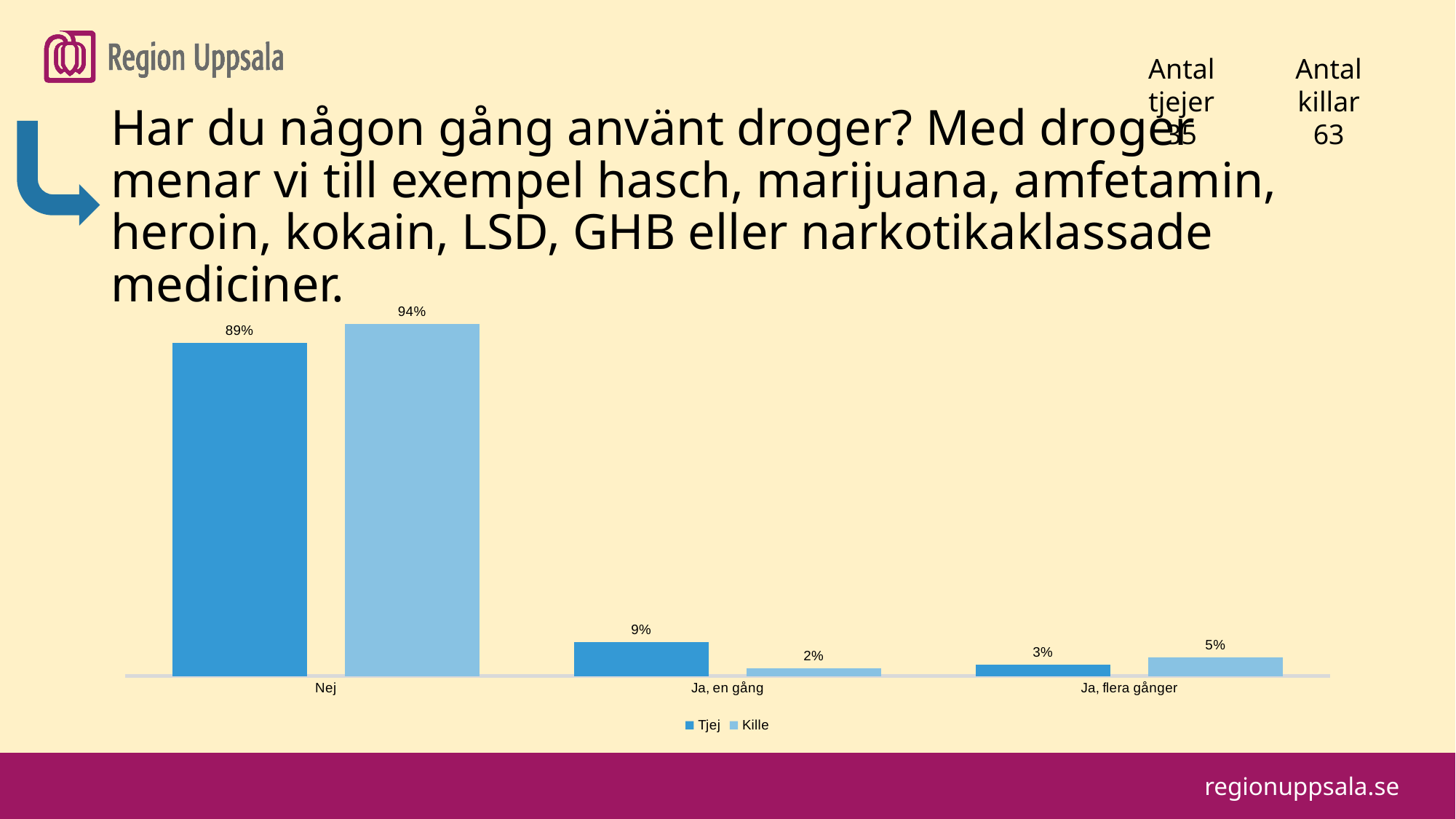
What are the two series names listed in the legend? Tjej and Kille How many categories are shown on the x axis? 3 What is the value for Kille in the 'Ja, flera gånger' category? 5% What is the value for Tjej in the 'Ja, en gång' category? 9% What kind of chart is shown on the slide? Bar chart In the 'Ja, en gång' category, which series has the larger value, Tjej or Kille? Tjej Which category has the lowest value for the Kille series? Ja, en gång How many series does the legend list? 2 What is the value for Tjej in the Nej category? 89% What is the difference between the Kille and Tjej values in the Nej category? 5% What is the value for Kille in the Nej category? 94% Which category has the highest value for the Kille series? Nej